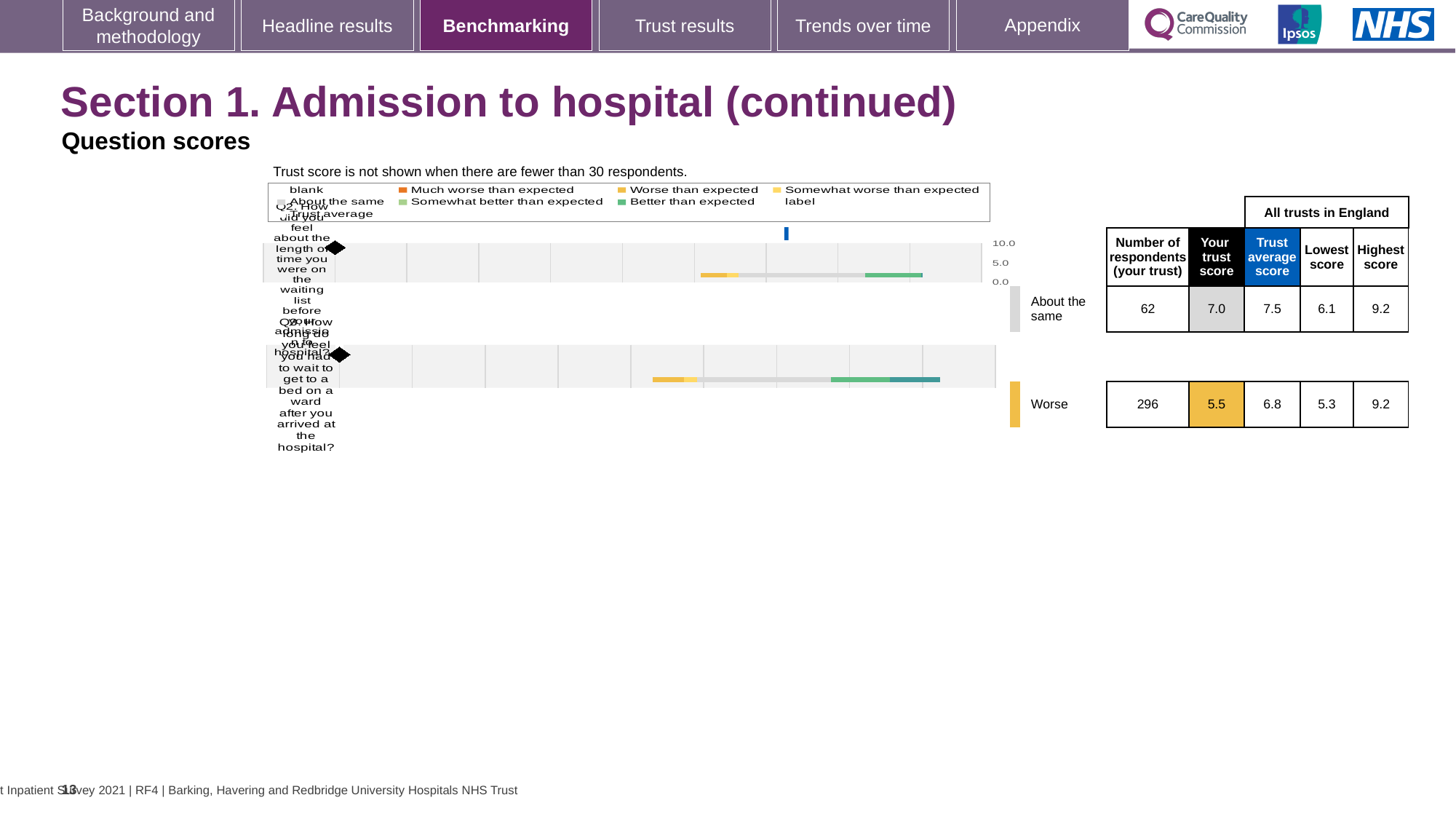
What is the 'Your trust score' for Q2 (length of time on the waiting list before admission)? 7.0 What is the difference between 'Your trust score' and the lowest score for Q2? 0.9 How many questions (Q2 and Q3) are plotted in the chart? 2 What is the 'Your trust score' for Q3 (wait to get to a bed on a ward after arriving at the hospital)? 5.5 What note is printed above the chart about when the trust score is not shown? Trust score is not shown when there are fewer than 30 respondents. What kind of chart is shown on the slide? bar chart What benchmark category is shown for Q3? Worse How many respondents from the trust answered Q3? 296 What is the difference between the trust average score and 'Your trust score' for Q3? 1.3 What is the highest score in England for Q3? 9.2 What is the trust average score across all trusts in England for Q2? 7.5 Which question has the higher 'Your trust score', Q2 or Q3? Q2